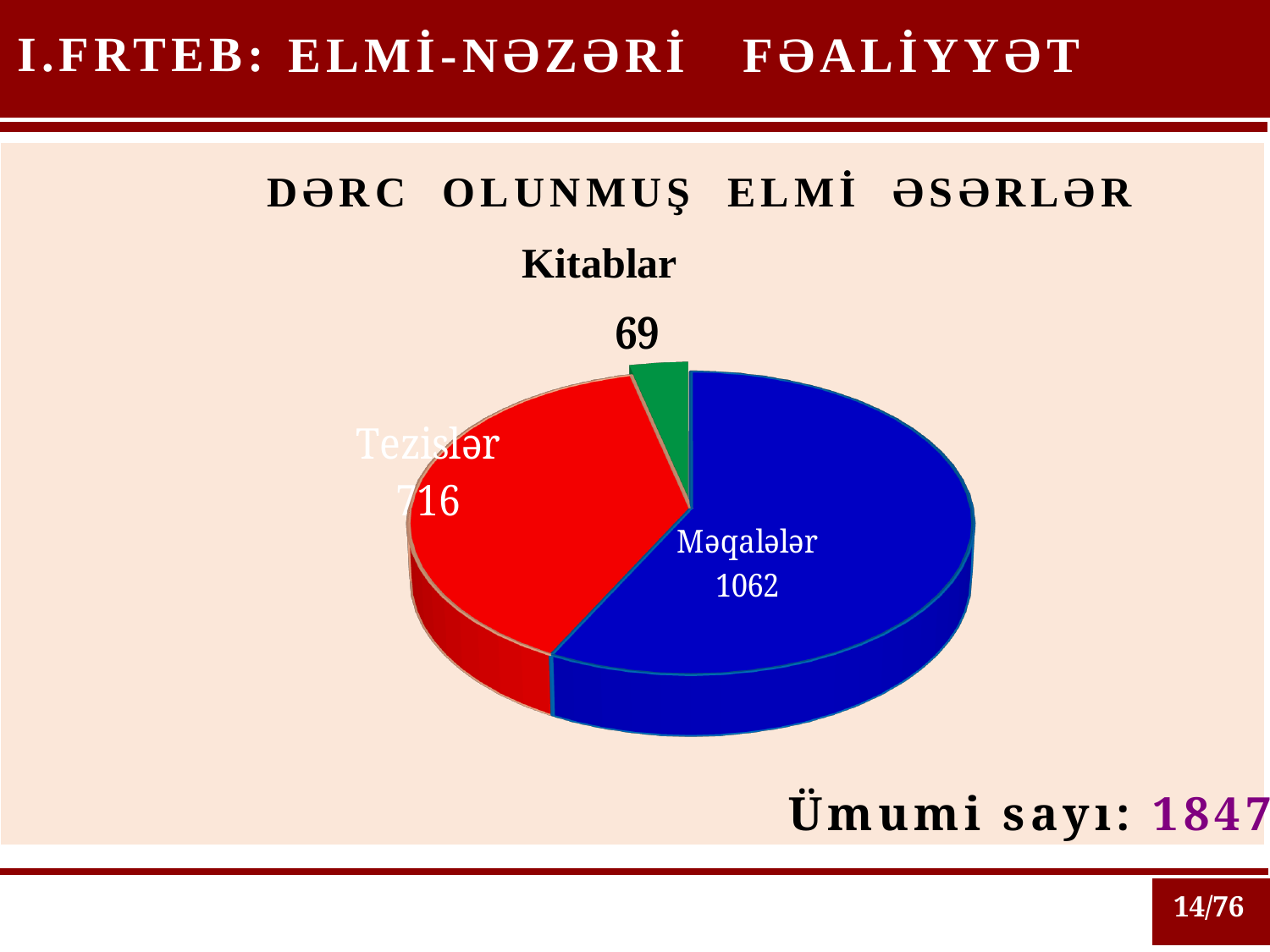
What type of chart is shown on the slide? pie chart What is the difference between the values for Məqalələr and Tezislər? 346 What is the total of all three slices (Ümumi sayı)? 1847 Which is larger, Tezislər or Kitablar? Tezislər What is the value for Kitablar? 69 What is the value for Tezislər? 716 What is the title of the chart? DƏRC OLUNMUŞ ELMİ ƏSƏRLƏR How many slices does the pie chart have? 3 Which category has the smallest slice? Kitablar What is the value for Məqalələr? 1062 Which category has the largest slice? Məqalələr What is the difference between the values for Tezislər and Kitablar? 647